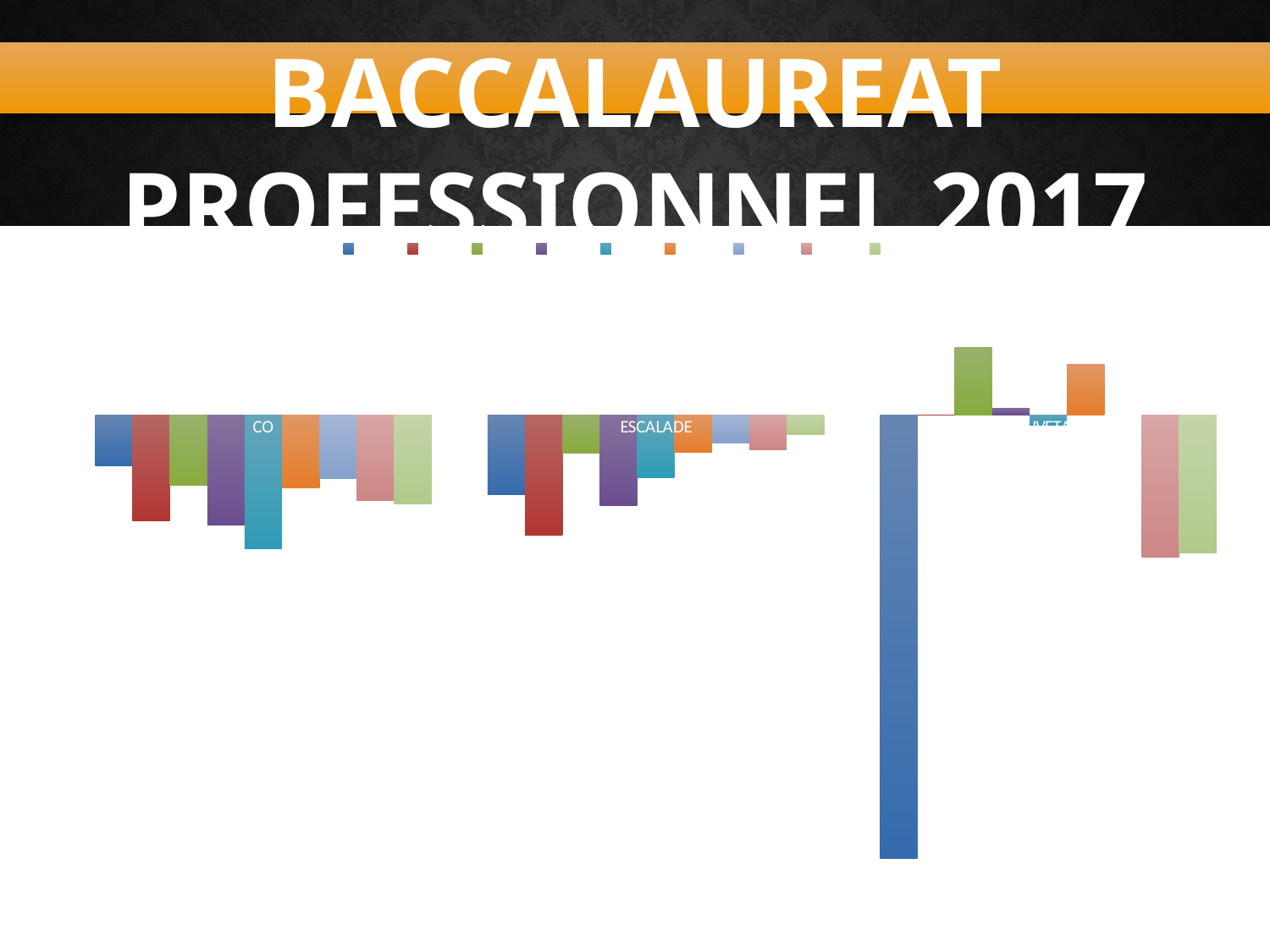
Which category group contains the longest bar on the chart? the rightmost group In the ESCALADE group, which bar is longer: the red bar or the green bar? the red bar What kind of chart is shown on the slide? bar chart What is the title shown at the top of the slide? BACCALAUREAT PROFESSIONNEL 2017 In the CO group, which colour bar extends furthest below the axis? teal How many category groups of bars does the chart show? 3 How many series does the legend list? 9